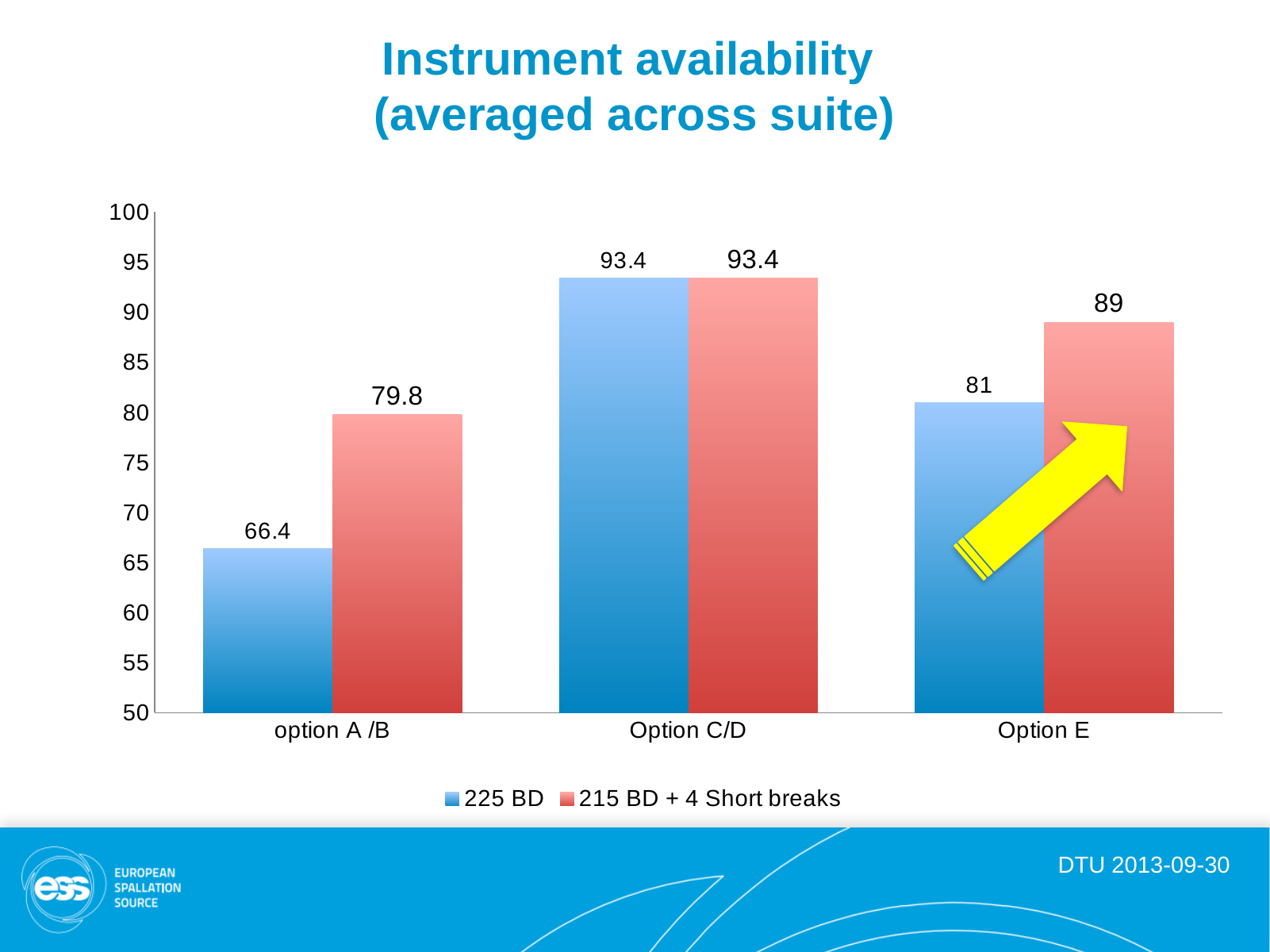
What is the title of the chart? Instrument availability (averaged across suite) What is the value for 225 BD for Option C/D? 93.4 What is the value for 215 BD + 4 Short breaks for option A /B? 79.8 How many series does the legend list? 2 What is the value for 225 BD for option A /B? 66.4 What kind of chart is shown on the slide? Bar chart How many categories are shown on the x axis? 3 Which is larger for option A /B: the 225 BD value or the 215 BD + 4 Short breaks value? 215 BD + 4 Short breaks Which category has the highest value for 225 BD? Option C/D What is the value for 215 BD + 4 Short breaks for Option E? 89 What is the difference between the 215 BD + 4 Short breaks value and the 225 BD value for Option E? 8 Which category has the lowest value for 215 BD + 4 Short breaks? option A /B